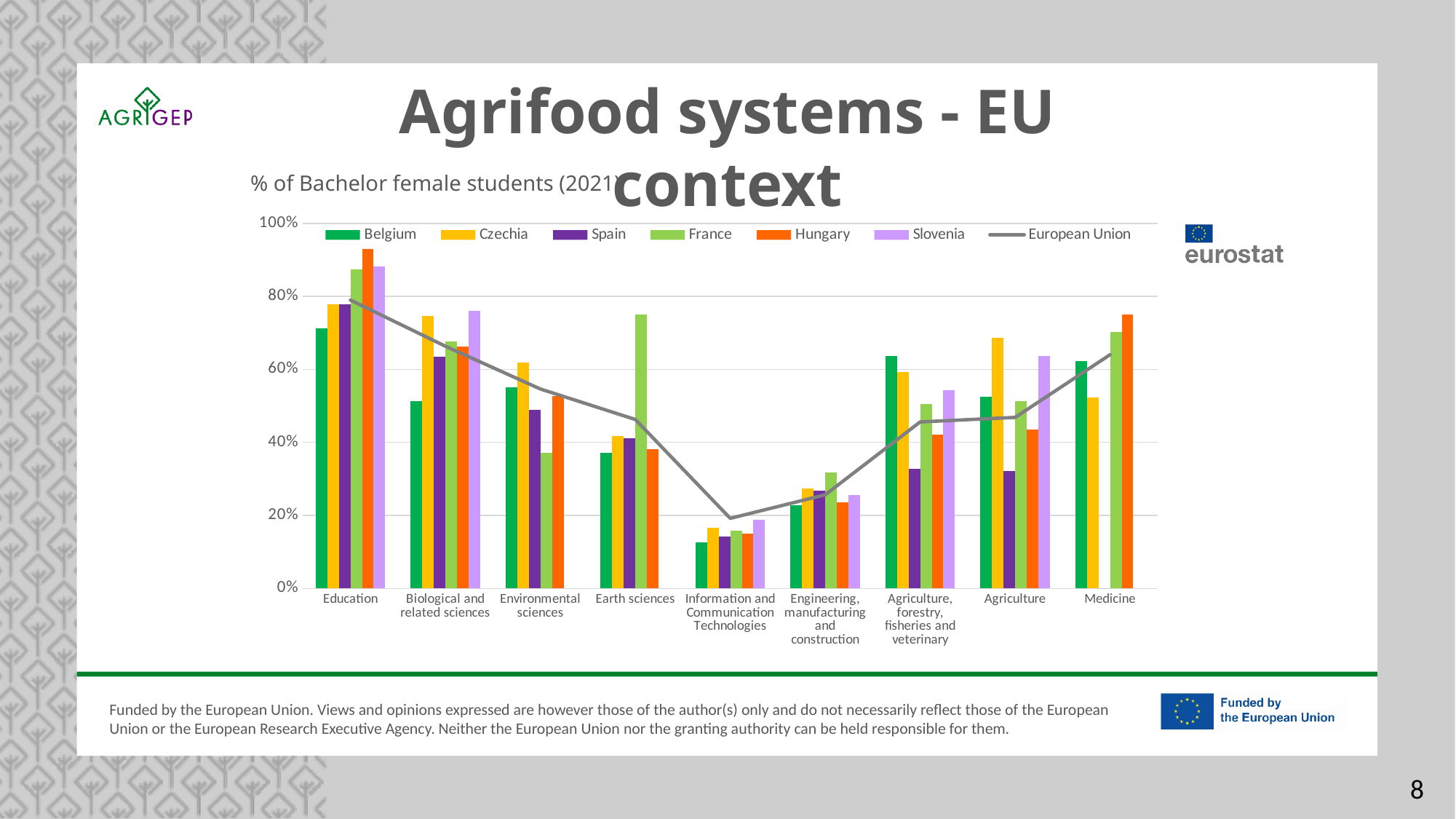
What is the title of the chart? % of Bachelor female students (2021) Which series is drawn as a line rather than bars? European Union Does the European Union line rise or fall from Education to Information and Communication Technologies? fall In the Medicine category, which is larger: Hungary or Czechia? Hungary In which category is the European Union line at its lowest point? Information and Communication Technologies Is the France value for Earth sciences greater or less than 60%? greater Is the Belgium value for Information and Communication Technologies greater or less than 20%? less What kind of chart is used on the slide? combination bar and line chart How many categories are shown along the x axis? 9 In the Agriculture category, which is larger: Czechia or Spain? Czechia In which category is the Hungary bar highest? Education How many series does the legend list? 7